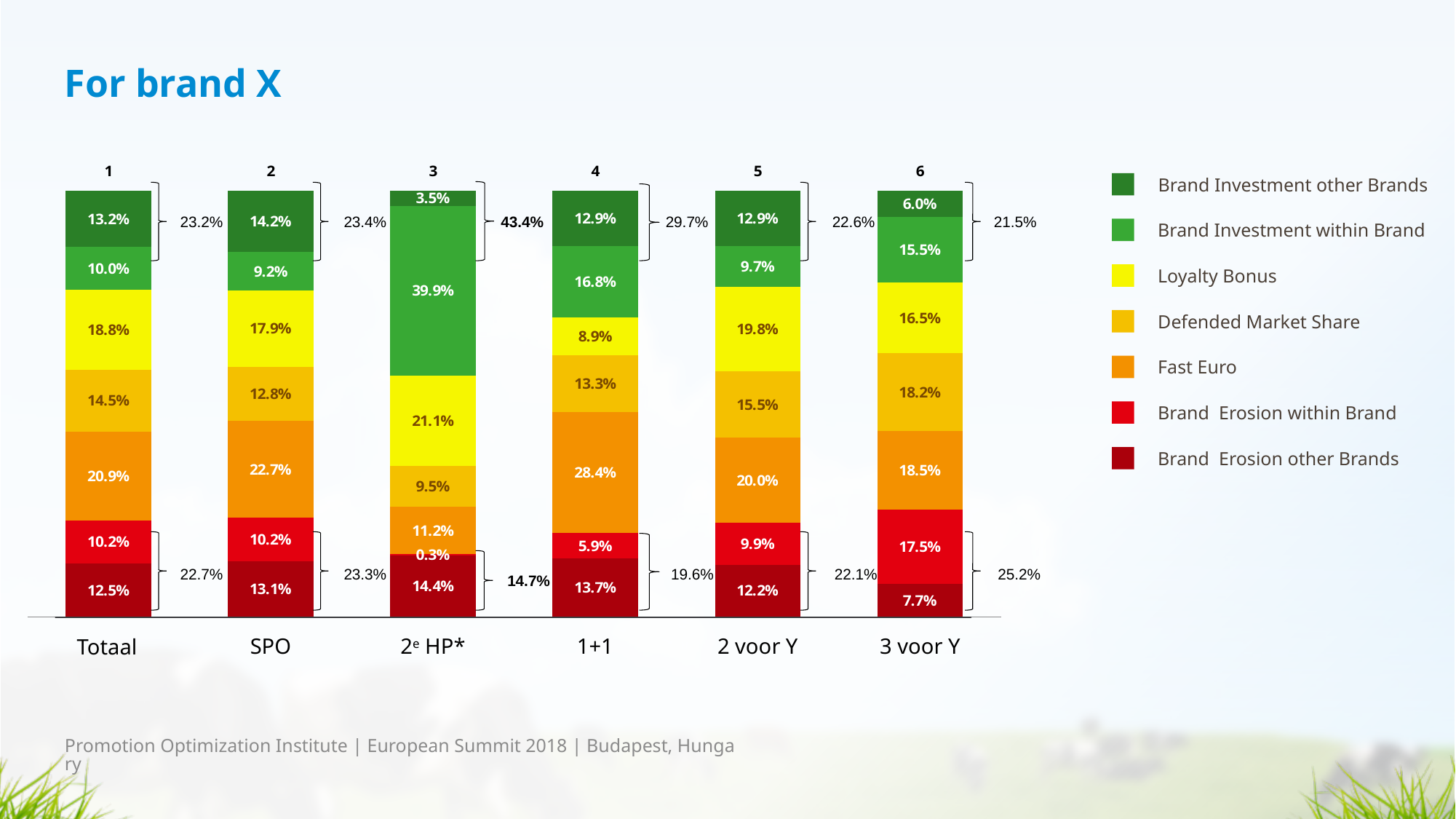
What is the title of the slide? For brand X What kind of chart is shown on the slide? Stacked bar chart What is the combined Brand Investment (other Brands plus within Brand) shown by the bracket for the 2e HP* bar? 43.4% Which category has the lowest Brand Erosion within Brand value? 2e HP* What is the difference between the Fast Euro values for 1+1 and Totaal? 7.5 percentage points What is the Fast Euro value for the 1+1 bar? 28.4% What is the Brand Investment within Brand value for the 2e HP* bar? 39.9% How many categories are shown on the x axis? 6 Which is larger: the Defended Market Share value for 3 voor Y or for SPO? 3 voor Y What is the Loyalty Bonus value for the Totaal bar? 18.8% How many series does the legend list? 7 Which category has the highest Brand Investment within Brand value? 2e HP*